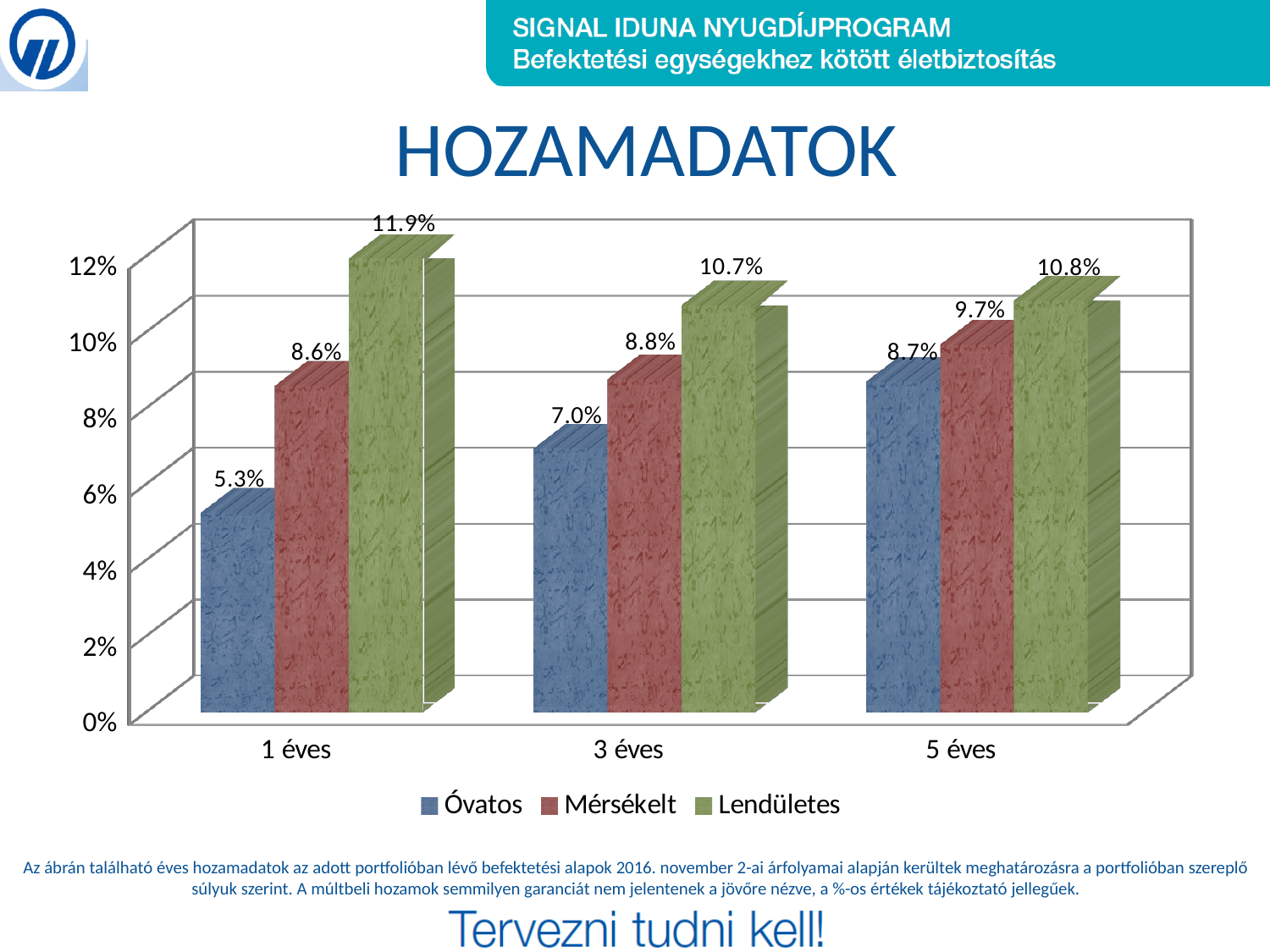
Which category has the lowest Óvatos value? 1 éves What is the value for Lendületes in the 3 éves category? 10.7% How many series does the legend list? 3 Which category has the highest Lendületes value? 1 éves What is the value for Mérsékelt in the 5 éves category? 9.7% What kind of chart is shown on the slide? Bar chart What is the difference between the Lendületes and Óvatos values in the 1 éves category? 6.6% What is the value for Óvatos in the 1 éves category? 5.3% Which is larger in the 3 éves category: Mérsékelt or Óvatos? Mérsékelt How many categories are shown on the x axis? 3 Do the Óvatos values rise or fall from 1 éves to 5 éves? Rise What is the title of the chart? HOZAMADATOK